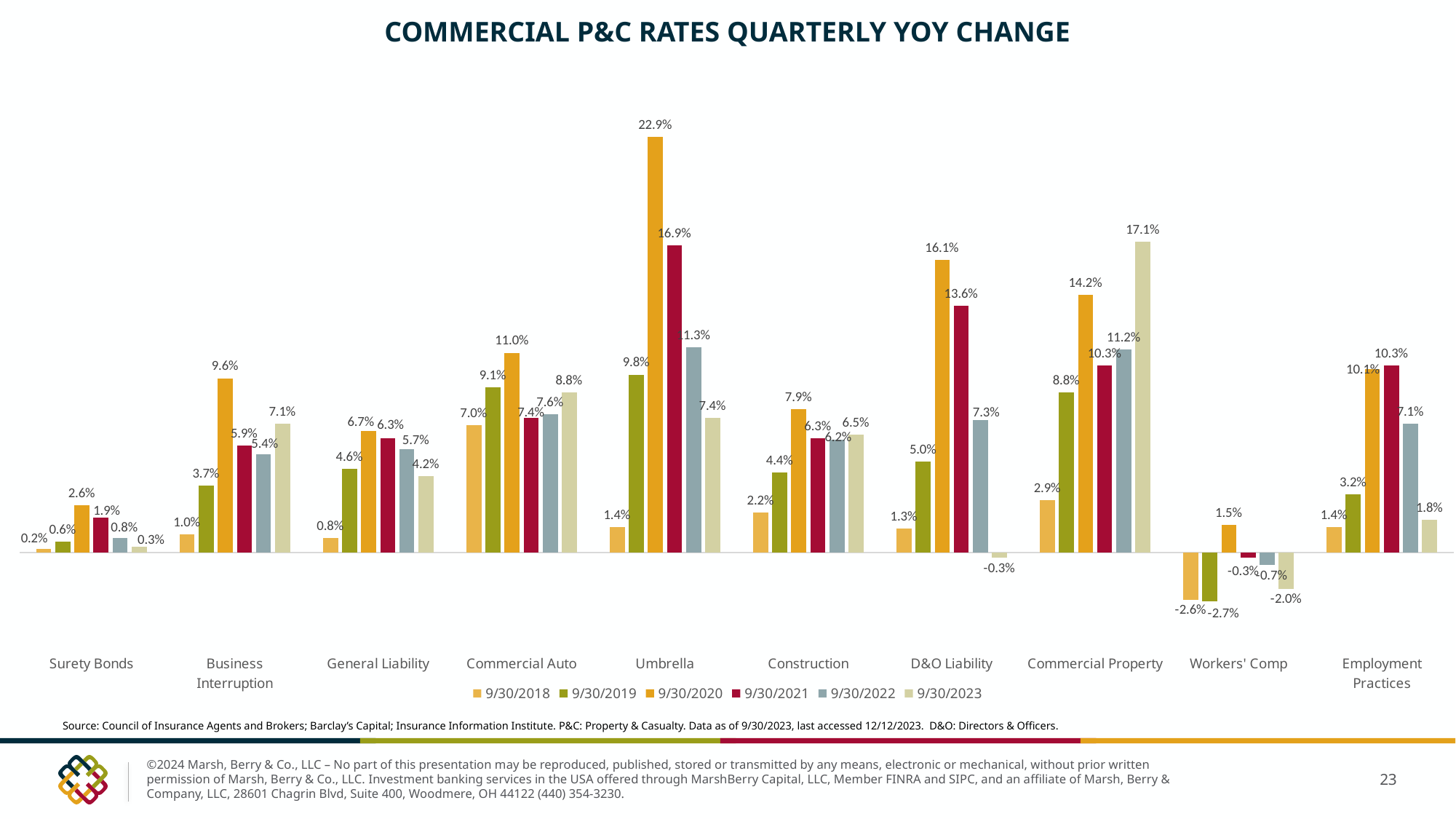
What is the value for Commercial Property in the 9/30/2023 series? 17.1% Which category has the highest value in the 9/30/2020 series? Umbrella How many series does the legend list? 6 What kind of chart is shown on the slide? Bar chart What is the difference between the 9/30/2020 and 9/30/2021 values for D&O Liability? 2.5% Which is larger for Business Interruption: the 9/30/2021 value or the 9/30/2023 value? 9/30/2023 What is the title of the chart? COMMERCIAL P&C RATES QUARTERLY YOY CHANGE What is the value for Umbrella in the 9/30/2020 series? 22.9% For Umbrella, do the values rise or fall from the 9/30/2020 series to the 9/30/2023 series? Fall How many categories are shown on the x axis? 10 Which category has the lowest value in the 9/30/2023 series? Workers' Comp What is the value for Workers' Comp in the 9/30/2019 series? -2.7%